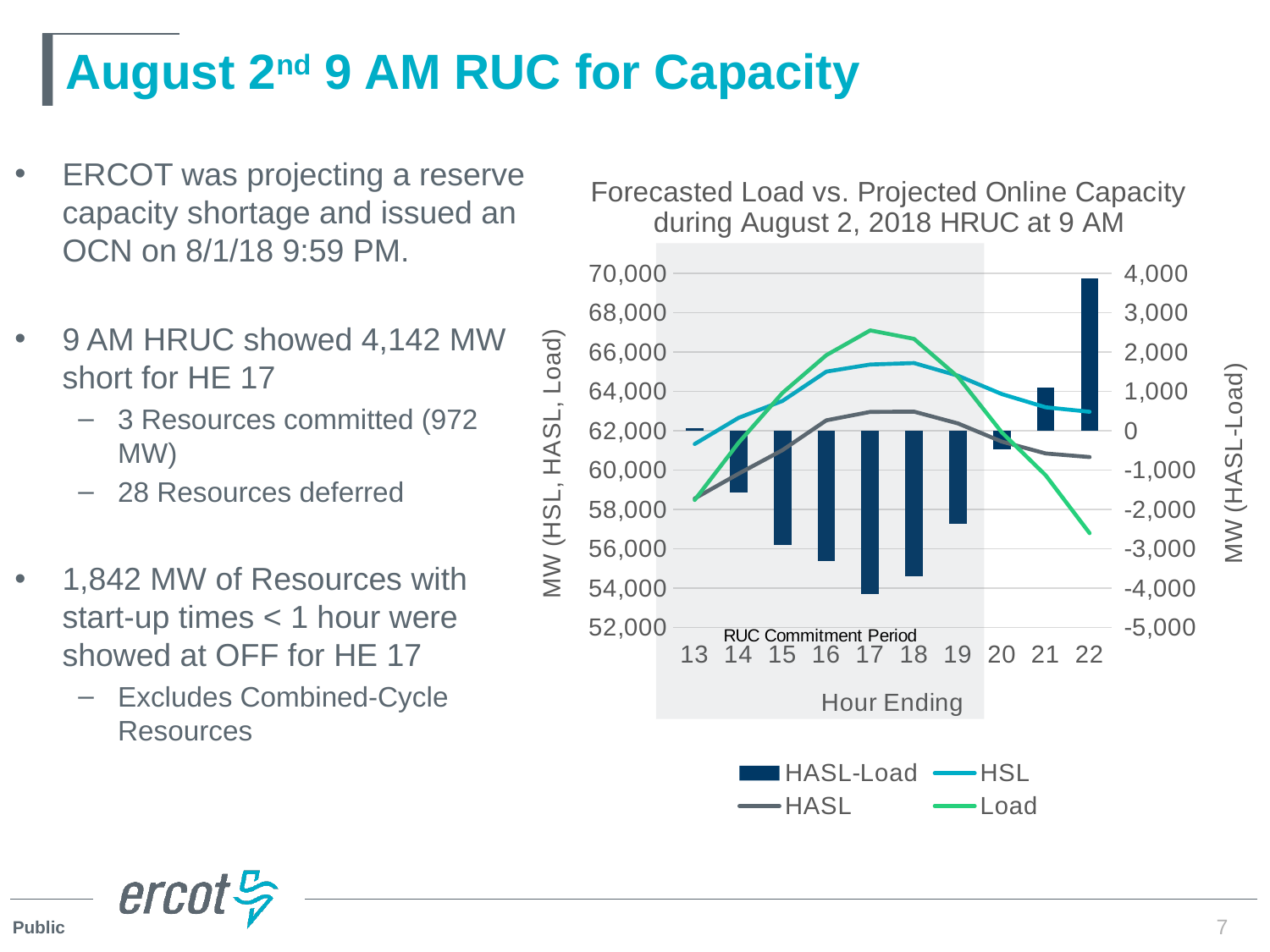
At hour ending 17, which is larger, Load or HSL? Load Is the Load value for hour ending 17 greater or less than 66,000? greater How many series does the chart legend list? 4 What kind of chart is shown on the slide? A combination bar and line chart Is the HASL-Load value for hour ending 17 greater or less than -4,000? less What is the label of the right-hand vertical axis? MW (HASL-Load) At which hour ending is the HASL-Load bar the highest? 22 Which series is plotted as bars in the chart? HASL-Load Is the HASL-Load value for hour ending 22 greater or less than 3,000? greater At which hour ending is the HASL-Load bar the lowest (most negative)? 17 How many hour-ending categories are shown on the x axis? 10 Does the Load line rise or fall from hour ending 18 to hour ending 22? Fall